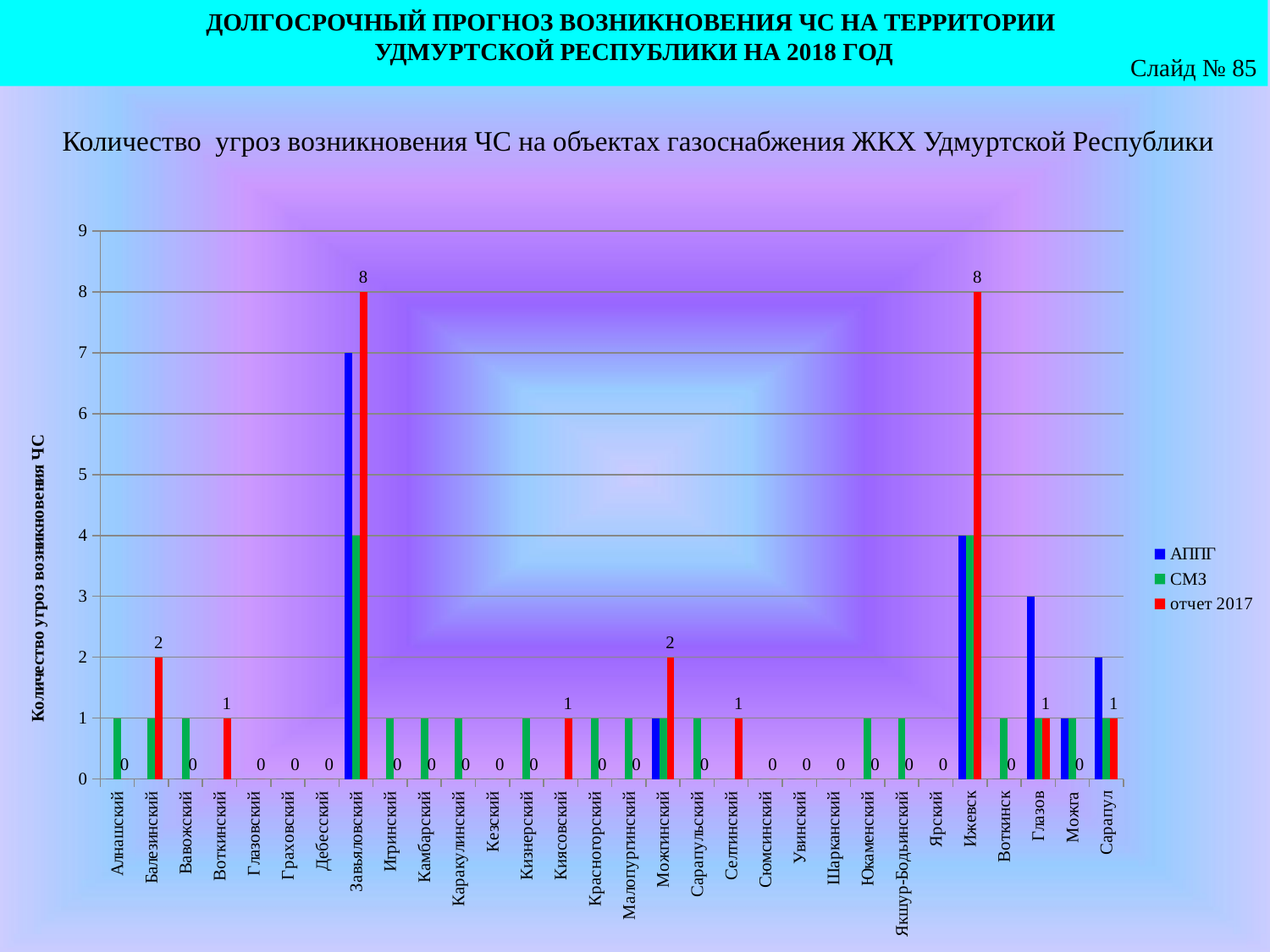
What is the value of отчет 2017 for Завьяловский? 8 What is the value of отчет 2017 for Можгинский? 2 Which colour represents the отчет 2017 series in the legend? red Which category has the highest АППГ value? Завьяловский What is the difference between the отчет 2017 values for Завьяловский and Можгинский? 6 How many categories are shown on the x axis? 30 Which has the larger отчет 2017 value, Балезинский or Воткинский? Балезинский What is the value of отчет 2017 for Балезинский? 2 Is the АППГ value for Завьяловский greater or less than 5? greater What kind of chart is shown on the slide? bar chart How many series does the legend list? 3 What is the value of отчет 2017 for Глазовский? 0